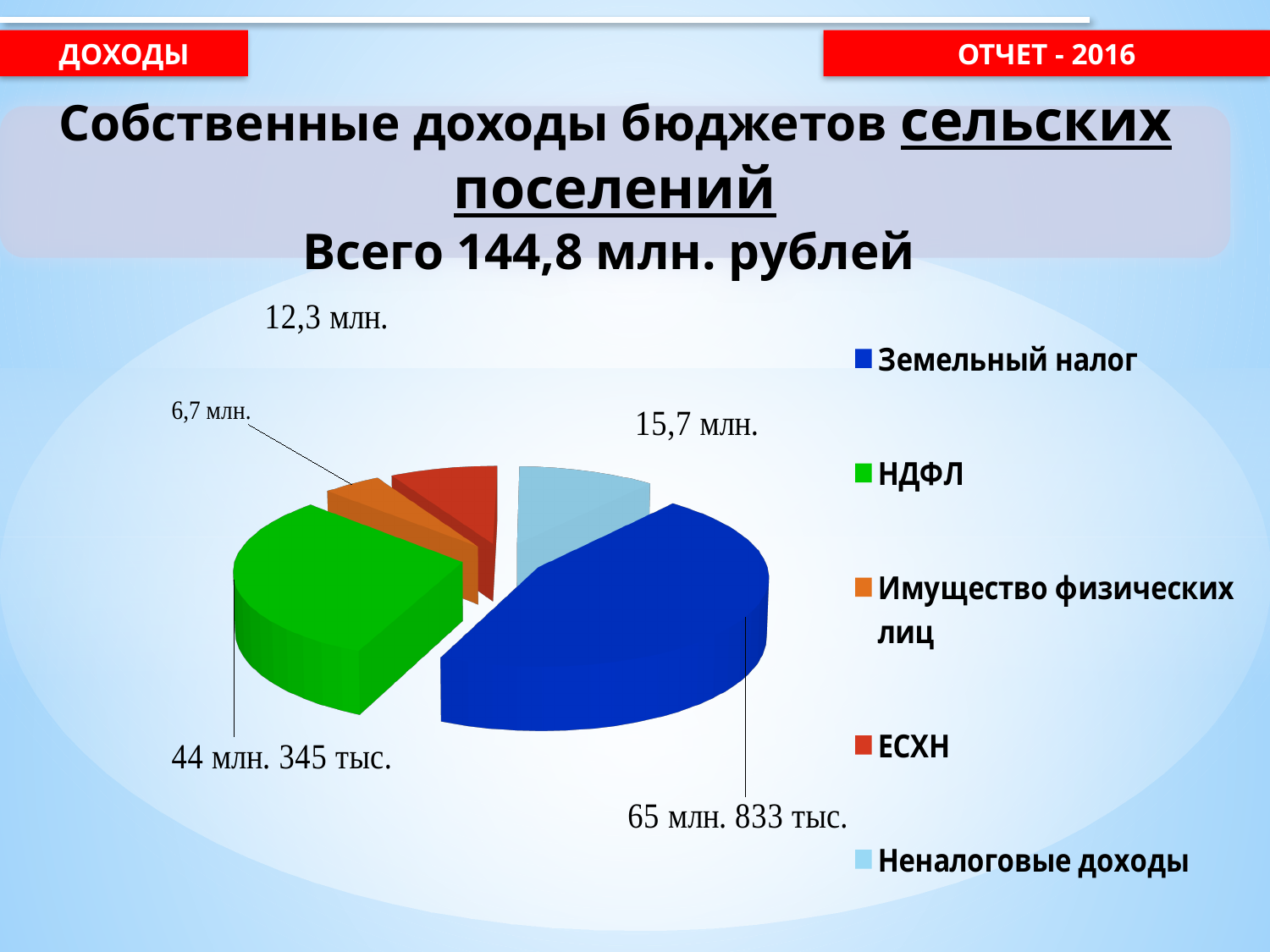
Which is larger, Неналоговые доходы or ЕСХН? Неналоговые доходы What is the value shown for Неналоговые доходы? 15,7 млн. Which category has the smallest slice of the pie? Имущество физических лиц What is the difference between the values for Неналоговые доходы (15,7 млн.) and ЕСХН (12,3 млн.)? 3,4 млн. What is the value shown for Земельный налог? 65 млн. 833 тыс. What is the value shown for НДФЛ? 44 млн. 345 тыс. What total amount is stated in the chart title? 144,8 млн. рублей What kind of chart is shown on the slide? pie chart What is the value shown for Имущество физических лиц? 6,7 млн. How many slices does the pie chart have? 5 How many entries does the legend list? 5 Which category has the largest slice of the pie? Земельный налог